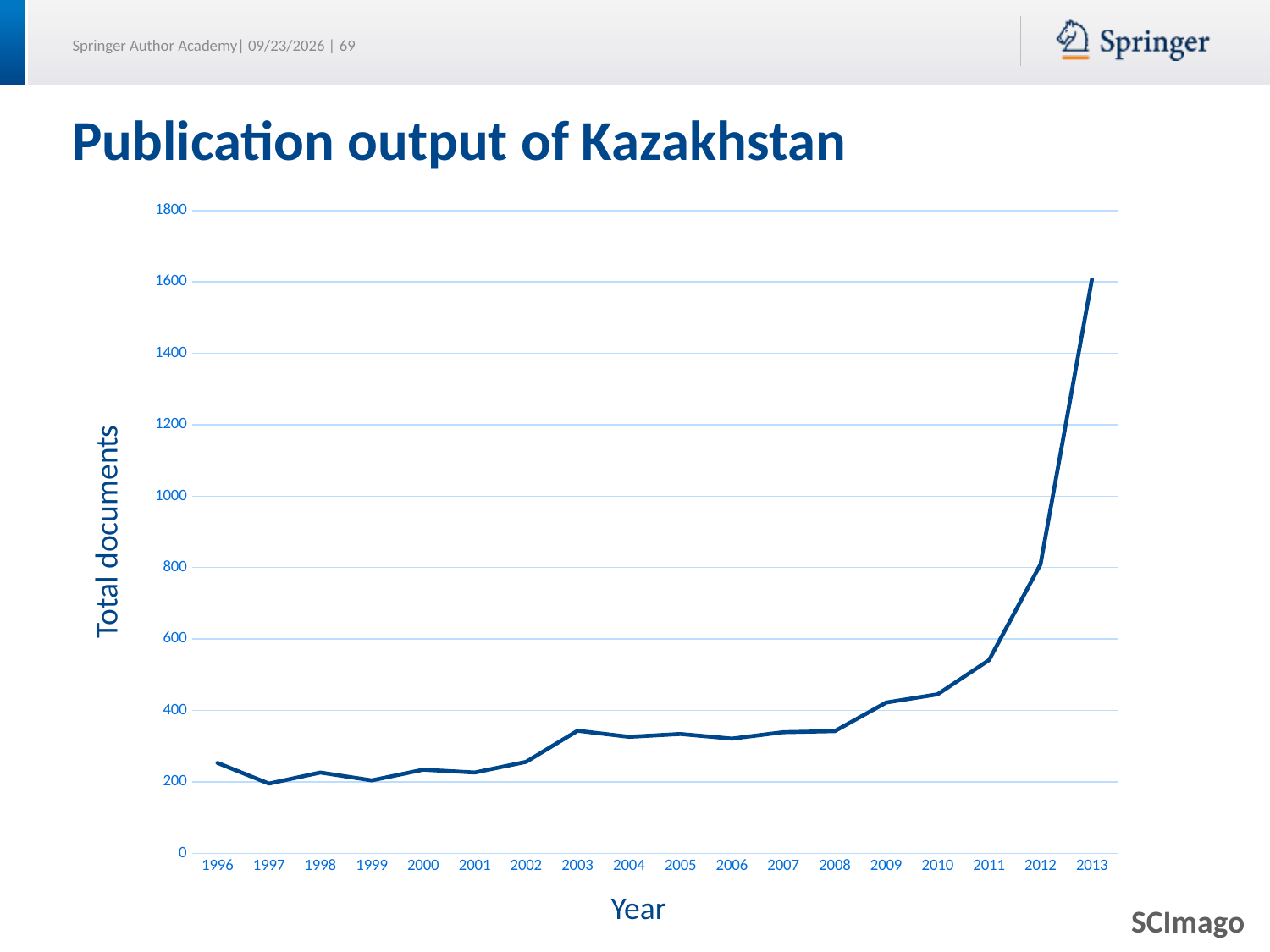
Do the values generally rise or fall from 2008 to 2013? rise Is the value for 2013 greater or less than 1400? greater Which year has the larger value, 2012 or 2008? 2012 What is the title of the chart? Publication output of Kazakhstan Is the value for 2012 greater or less than 600? greater Is the value for 2011 greater or less than 800? less How many years are plotted on the x axis? 18 What kind of chart is shown on the slide? line chart Which year has the highest total documents? 2013 What is the label on the vertical axis? Total documents